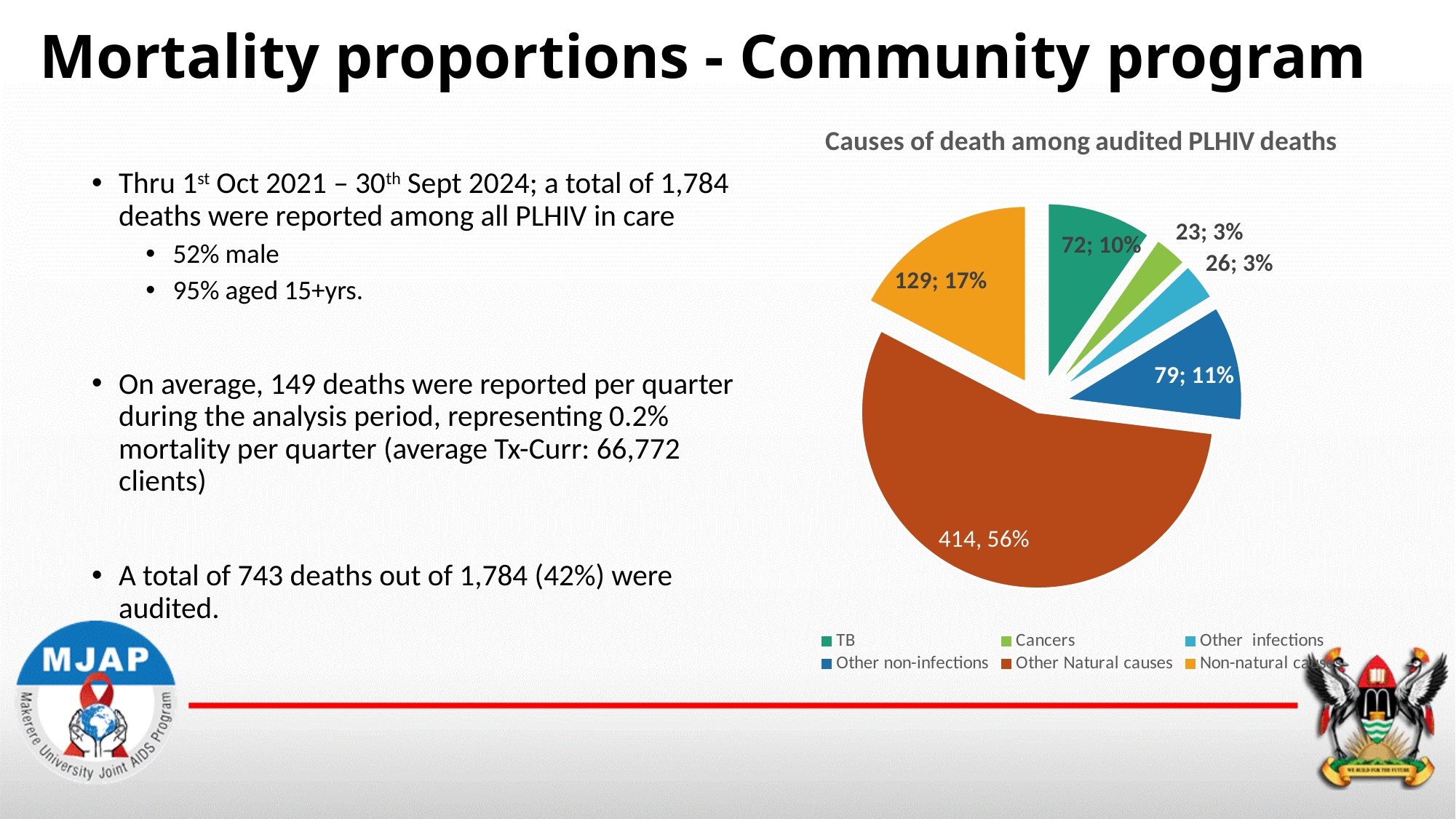
How many categories does the legend of the pie chart list? 6 What colour is the slice for Other Natural causes? brown What is the title of the chart? Causes of death among audited PLHIV deaths What percentage of audited deaths was due to Other non-infections? 11% Which accounts for more audited deaths, Other non-infections or TB? Other non-infections What share of audited deaths was due to Other Natural causes? 56% How many audited deaths were attributed to Non-natural causes? 129 How many audited deaths were attributed to TB? 72 Which cause of death has the largest slice of the pie? Other Natural causes Which cause of death has the smallest slice of the pie? Cancers What type of chart is shown on the slide? pie chart What is the difference between the number of deaths from Non-natural causes and from TB? 57